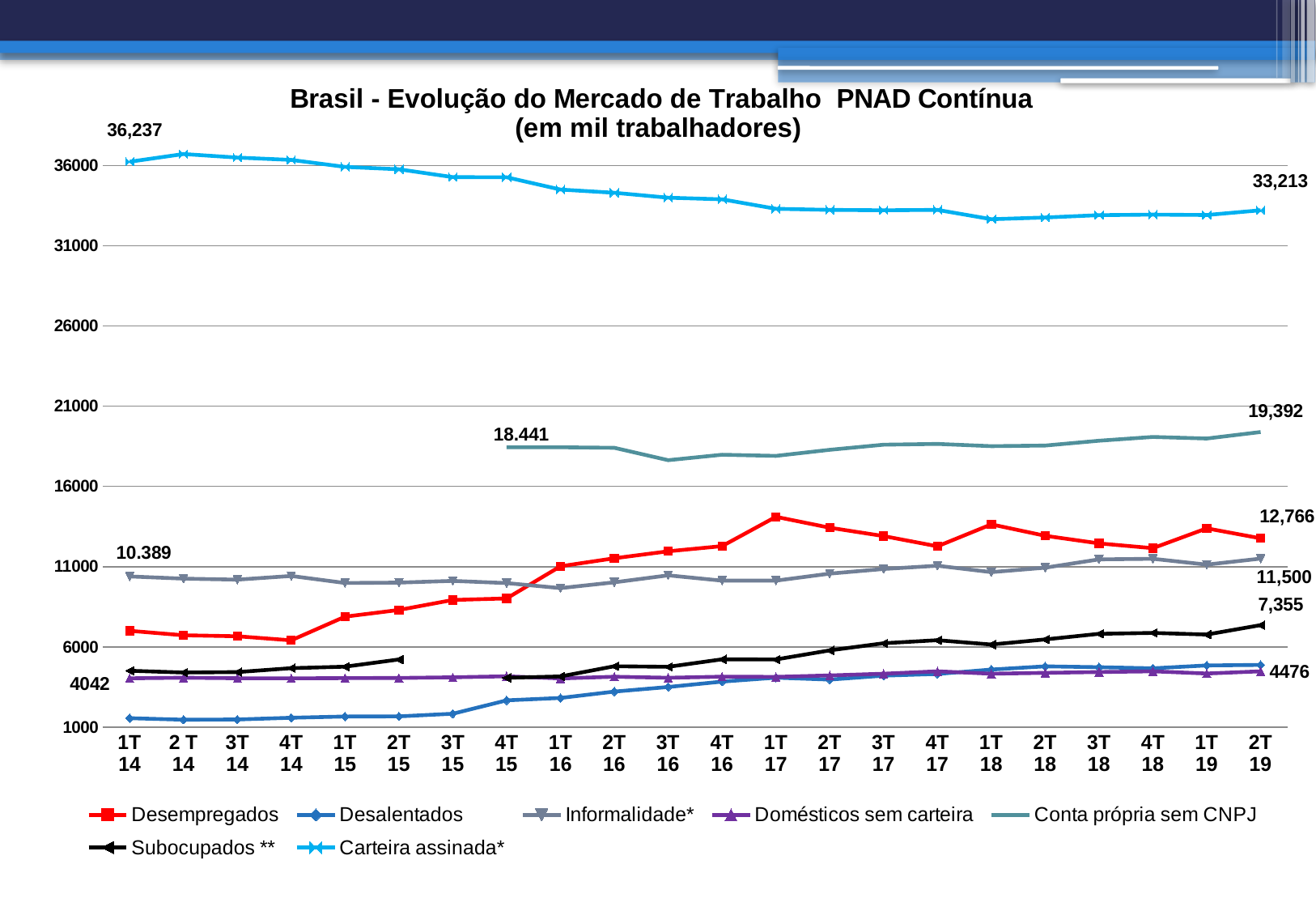
By how much did Carteira assinada* fall from 1T 14 (36,237) to 2T 19 (33,213)? 3,024 What is the value for Carteira assinada* in 1T 14? 36,237 What is the value for Carteira assinada* in 2T 19? 33,213 Does the Carteira assinada* line rise or fall from 1T 14 to 2T 19? fall What is the value for Desempregados in 2T 19? 12,766 What is the value for Conta própria sem CNPJ in 2T 19? 19,392 In 2T 19, which is larger: Desempregados or Informalidade*? Desempregados How many series does the legend list? 7 Which series has the highest value in 2T 19? Carteira assinada* Is the value for Desempregados in 1T 17 greater or less than 11000? greater How many quarters are plotted along the x axis? 22 What kind of chart is shown on the slide? line chart